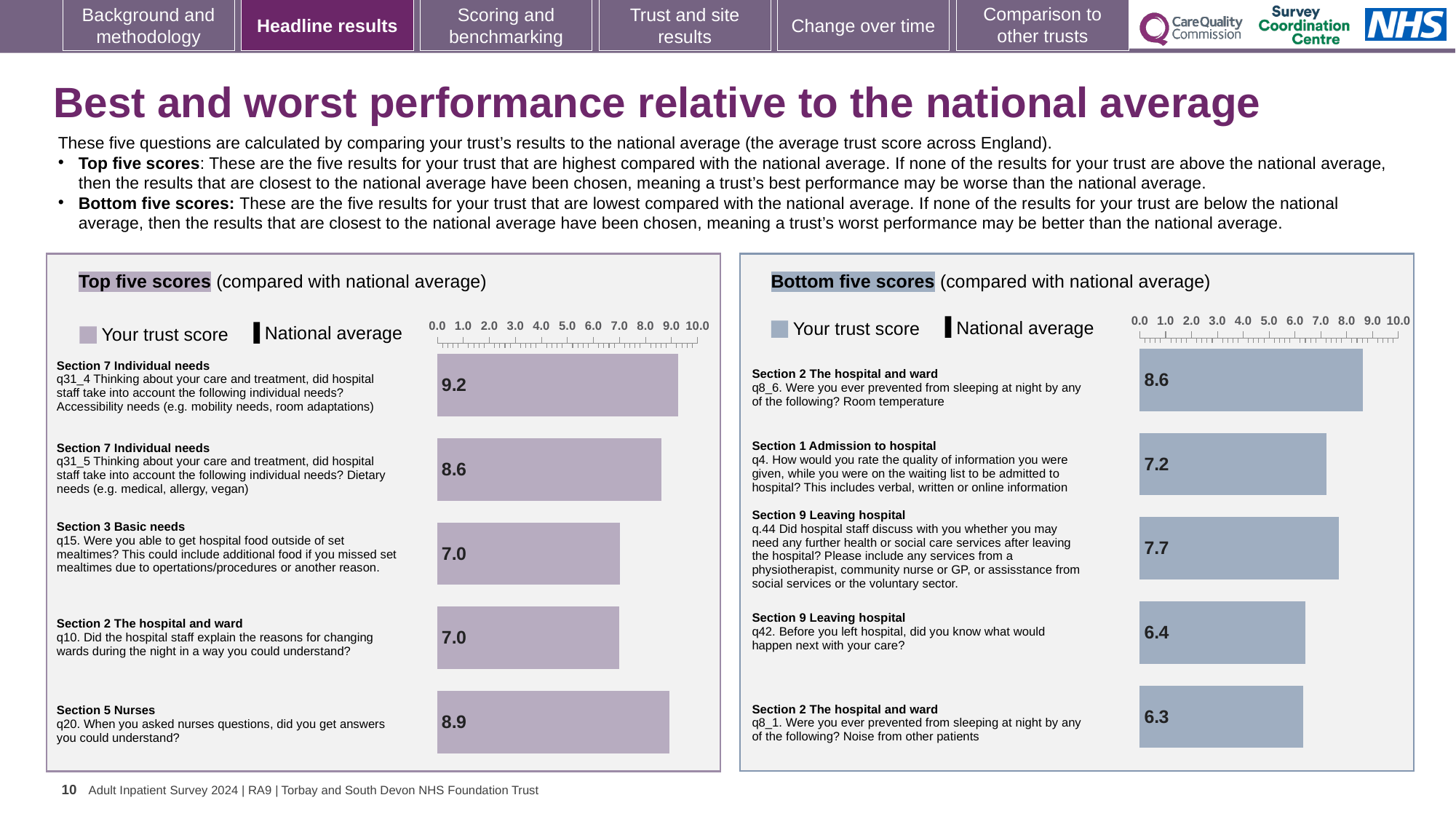
In the Bottom five scores chart, which question has the highest trust score? q8_6 (Room temperature) In the Bottom five scores chart, what is the difference between the scores for q.44 and q42? 1.3 In the Top five scores chart, which has the larger score: q20 or q31_5? q20 In the Bottom five scores chart, what is the trust score for q4 (quality of information given while on the waiting list)? 7.2 What type of chart is used for the Top five scores? Bar chart In the Top five scores chart, what is the difference between the scores for q31_4 and q31_5? 0.6 In the Bottom five scores chart, which question has the lowest trust score? q8_1 (Noise from other patients) In the Top five scores chart, what is the trust score for q31_4 (Accessibility needs)? 9.2 How many bars are shown in the Bottom five scores chart? 5 In the Top five scores chart, which question has the highest trust score? q31_4 (Accessibility needs) In the Bottom five scores chart, what is the trust score for q42 (Before you left hospital, did you know what would happen next with your care)? 6.4 In the Top five scores chart, what is the trust score for q20 (When you asked nurses questions, did you get answers you could understand)? 8.9